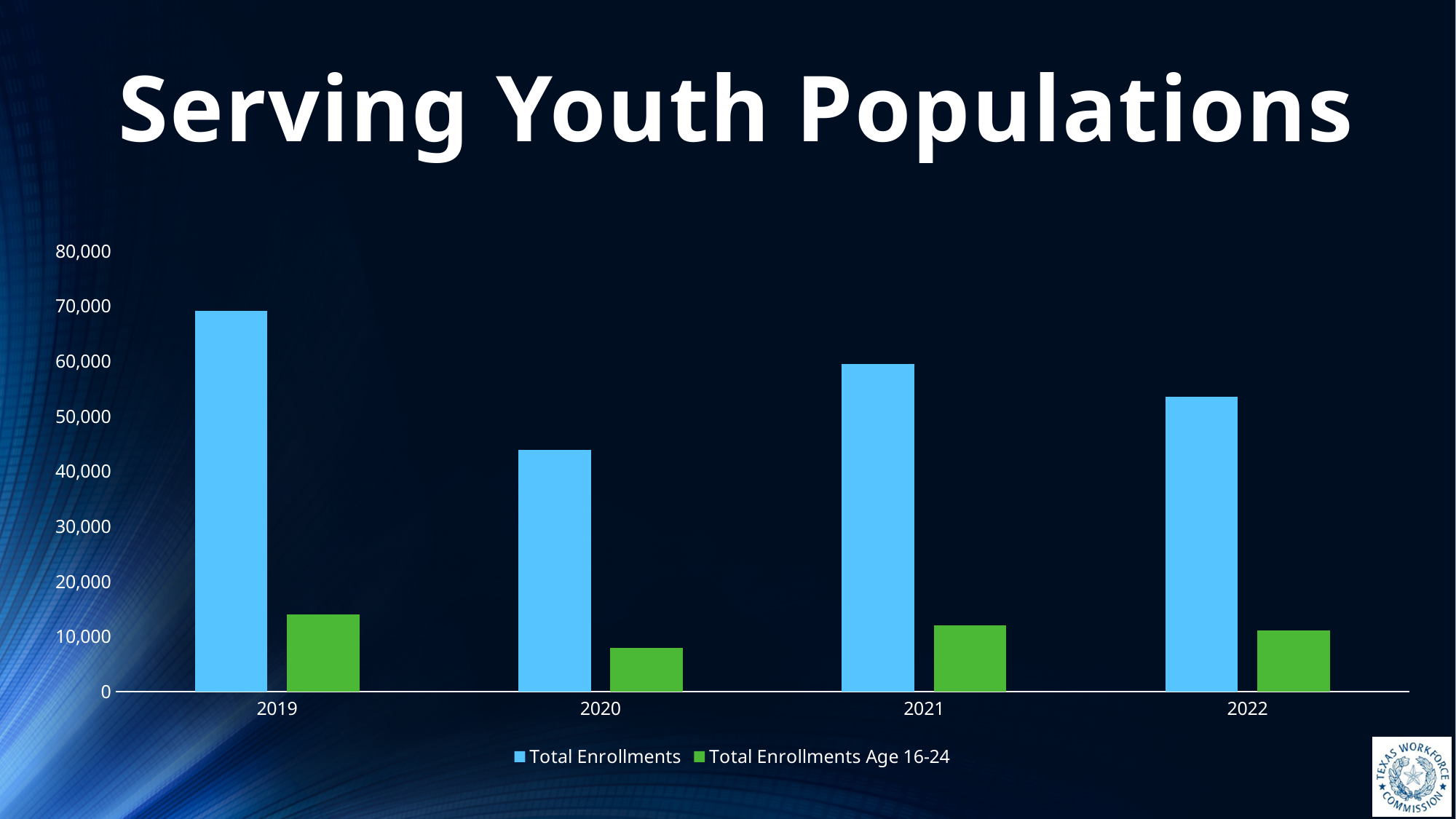
In which year is Total Enrollments Age 16-24 highest? 2019 In which year is Total Enrollments lowest? 2020 In which year is Total Enrollments Age 16-24 lowest? 2020 Is the value for Total Enrollments Age 16-24 in 2020 greater or less than 10,000? less In which year is Total Enrollments highest? 2019 What kind of chart is shown on the slide? Bar chart What is the title of the slide containing the chart? Serving Youth Populations Which year has the larger Total Enrollments, 2021 or 2022? 2021 How many years are shown on the x axis of the chart? 4 Is the value for Total Enrollments in 2019 greater or less than 60,000? greater Is the value for Total Enrollments in 2020 greater or less than 50,000? less How many series does the chart's legend list? 2